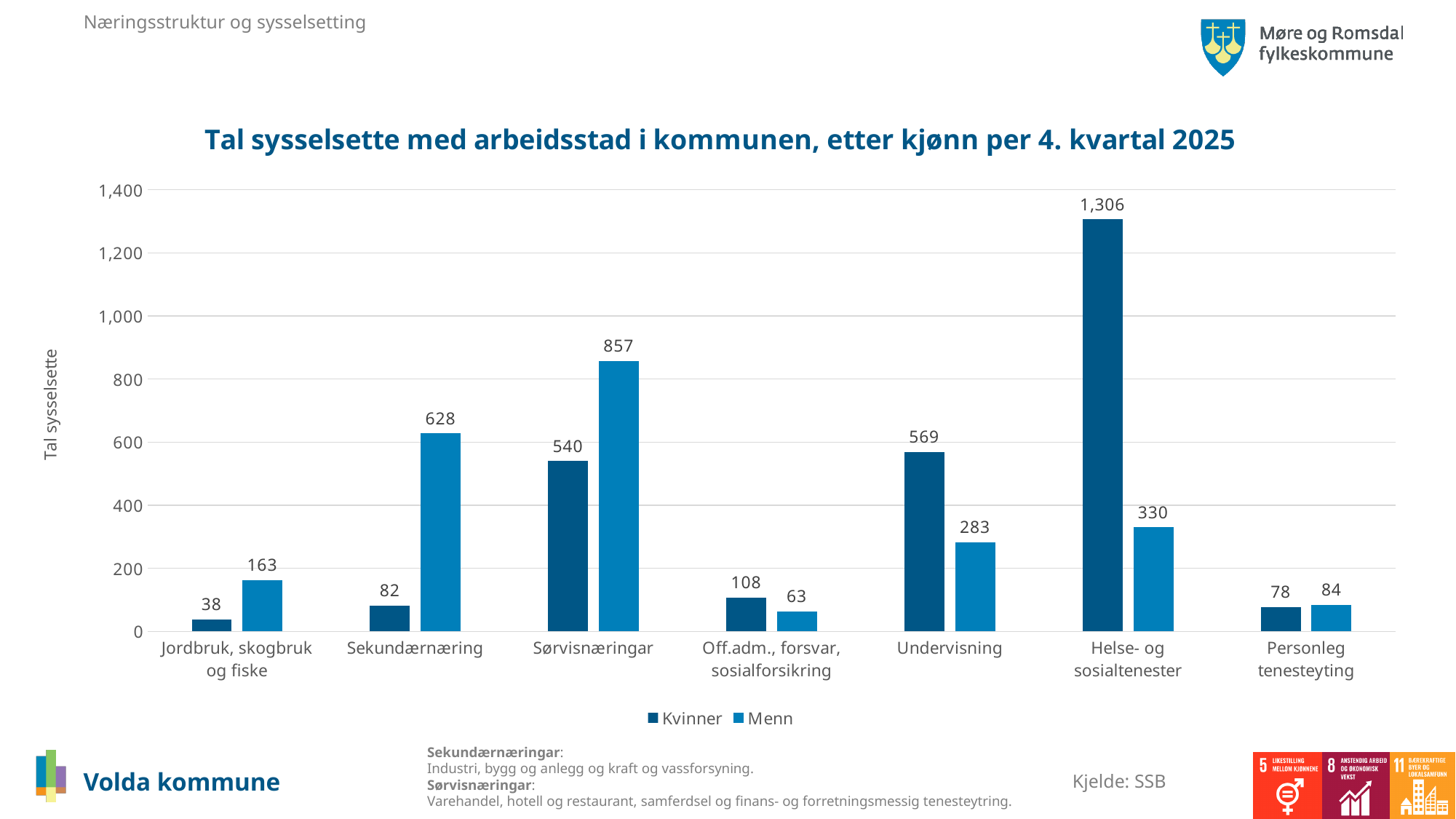
What is the total of Kvinner and Menn in Personleg tenesteyting? 162 What is the value for Kvinner in Off.adm., forsvar, sosialforsikring? 108 What is the value for Kvinner in Helse- og sosialtenester? 1,306 How many series does the legend list? 2 Which is larger in Sørvisnæringar, Kvinner or Menn? Menn Which category has the highest value for Menn? Sørvisnæringar What kind of chart is shown on the slide? Bar chart Which category has the lowest value for Kvinner? Jordbruk, skogbruk og fiske What is the value for Menn in Sekundærnæring? 628 How many categories are shown on the x axis? 7 What is the difference between Kvinner and Menn in Undervisning? 286 What is the label of the y axis? Tal sysselsette